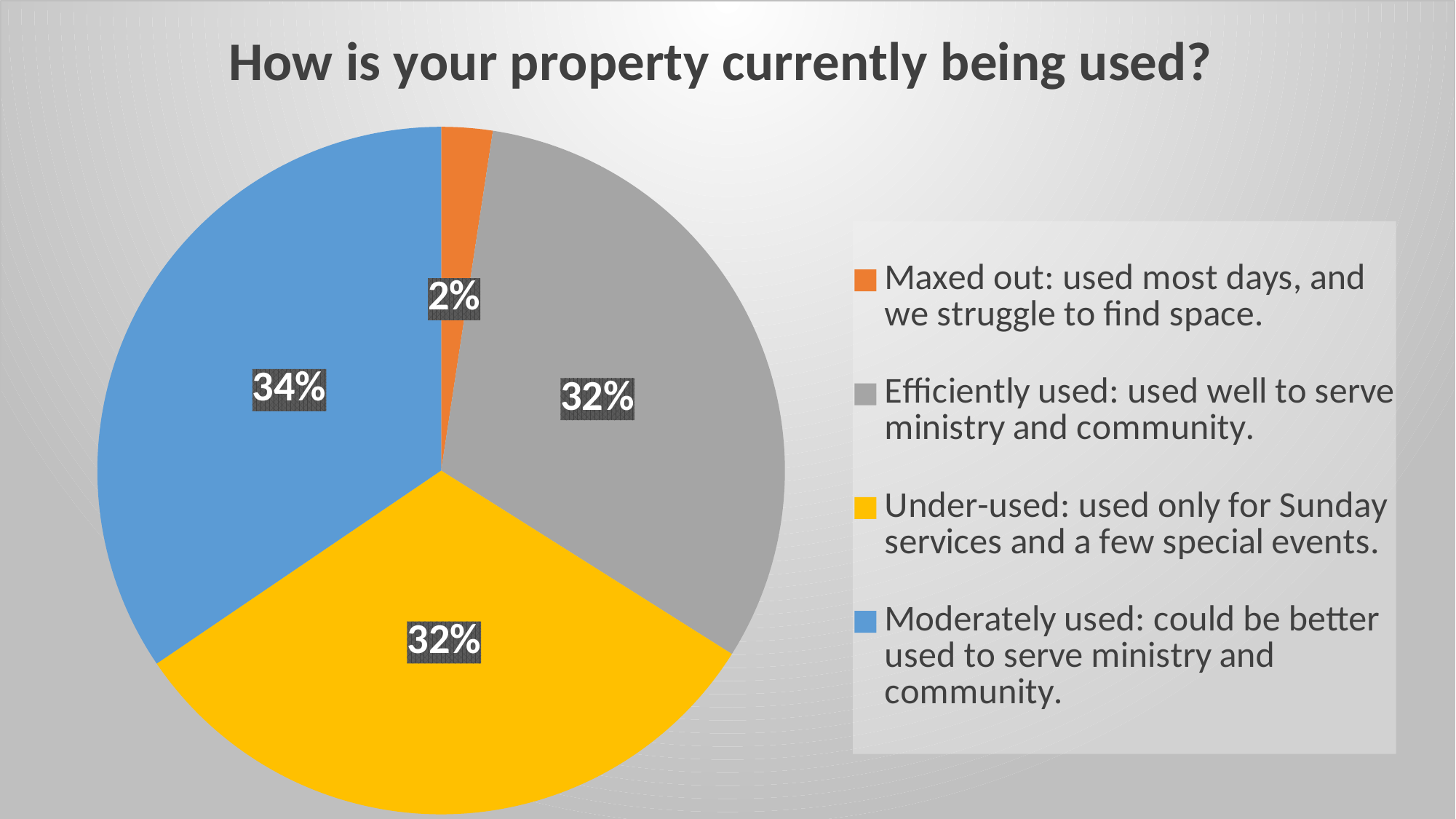
What percentage of respondents said their property is "Moderately used"? 34% What percentage of respondents said their property is "Efficiently used"? 32% How many categories does the legend list? 4 What colour is the "Under-used" slice? yellow What is the chart's title? How is your property currently being used? What percentage of respondents said their property is "Under-used"? 32% Which is larger, the "Moderately used" slice or the "Maxed out" slice? Moderately used What percentage of respondents said their property is "Maxed out"? 2% Which category has the smallest share of the pie? Maxed out What kind of chart is shown on the slide? pie chart What is the difference in percentage points between the "Moderately used" and "Maxed out" slices? 32 Which category has the largest share of the pie? Moderately used